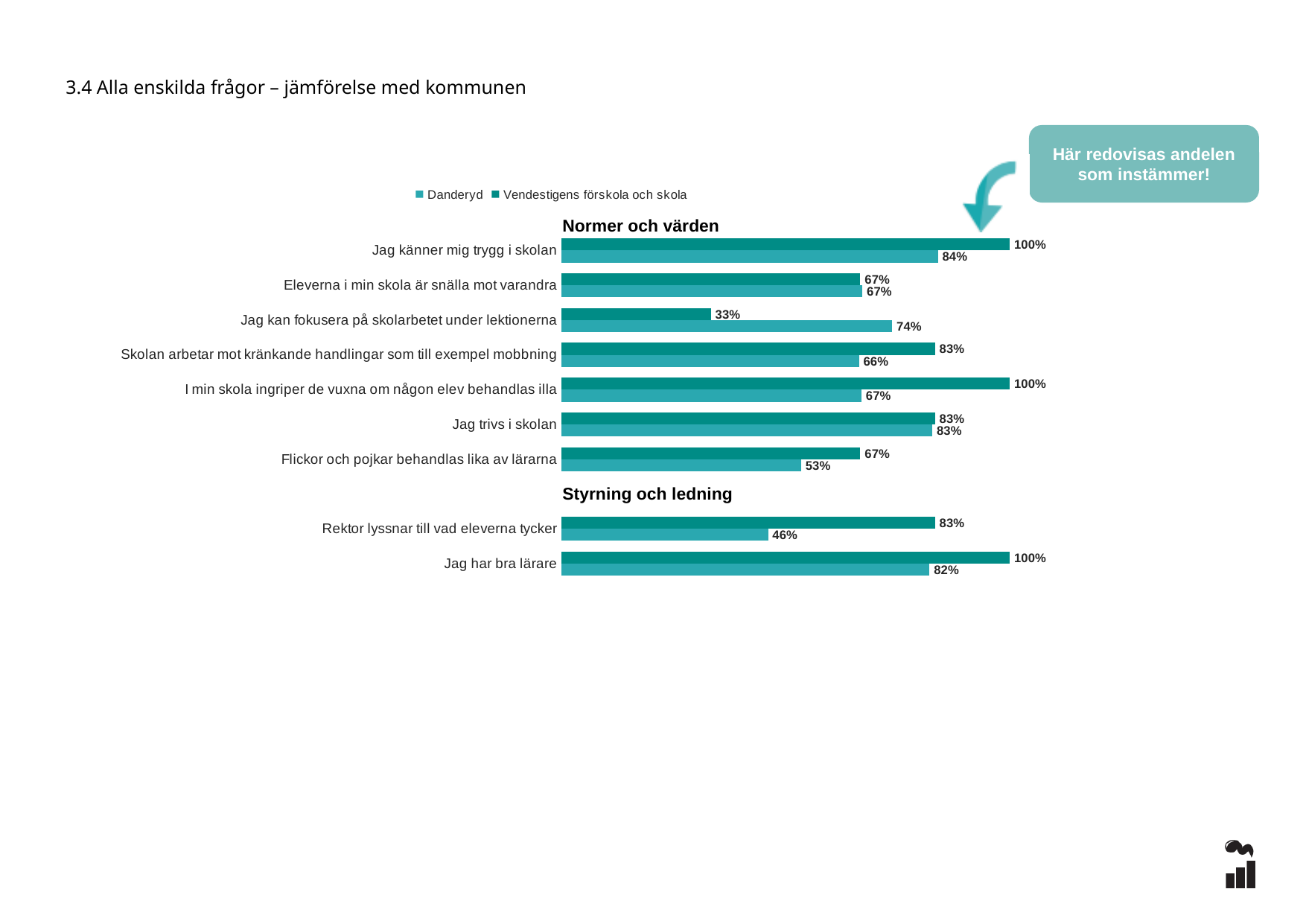
What is the value for Vendestigens förskola och skola for "Jag känner mig trygg i skolan"? 100% Which category has the lowest value for Vendestigens förskola och skola? Jag kan fokusera på skolarbetet under lektionerna For "Jag kan fokusera på skolarbetet under lektionerna", which series has the larger value, Danderyd or Vendestigens förskola och skola? Danderyd How many question categories are plotted in the chart? 9 What are the two section headings shown within the chart? Normer och värden; Styrning och ledning What is the difference between Vendestigens förskola och skola and Danderyd for "Flickor och pojkar behandlas lika av lärarna"? 14% How many series does the legend list? 2 What kind of chart is shown on the slide? bar chart What is the value for Danderyd for "Rektor lyssnar till vad eleverna tycker"? 46% Which category has the highest value for Danderyd? Jag känner mig trygg i skolan What is the difference between Vendestigens förskola och skola and Danderyd for "Rektor lyssnar till vad eleverna tycker"? 37% What is the value for Danderyd for "Jag kan fokusera på skolarbetet under lektionerna"? 74%